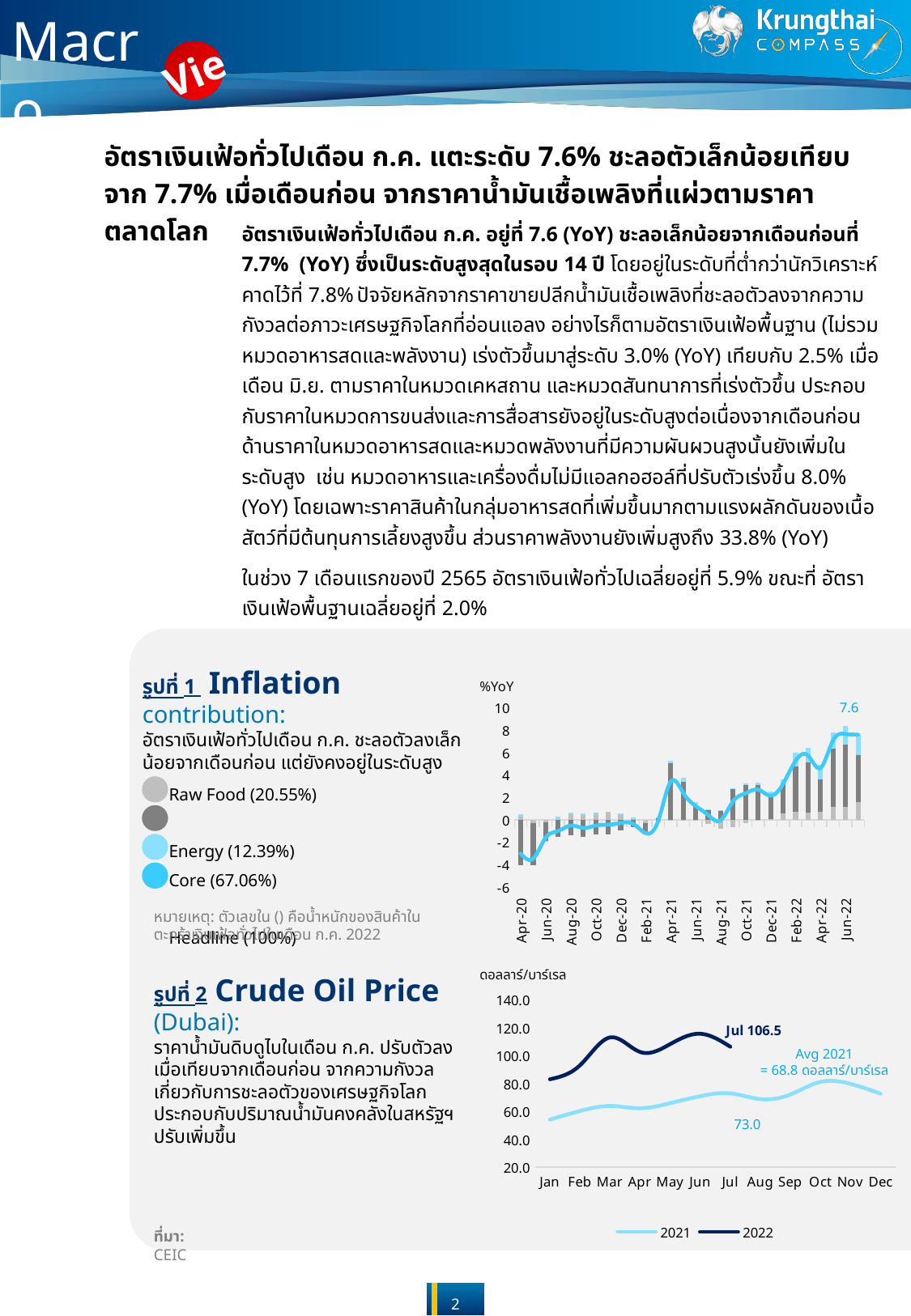
In the Inflation contribution chart, does the Headline line rise or fall from Feb-22 to Jun-22? rise In the Inflation contribution chart, is the Headline value in Apr-20 greater or less than 0? less In the Crude Oil Price (Dubai) chart, which series is higher in Jul, 2021 or 2022? 2022 In the Crude Oil Price (Dubai) chart, what is the difference between the Jul 2022 value and the stated 2021 average? 37.7 How many series does the legend of the Crude Oil Price (Dubai) chart list? 2 In the Crude Oil Price (Dubai) chart, what is the average 2021 price stated on the chart? 68.8 ดอลลาร์/บาร์เรล In the Inflation contribution chart, what weight is shown in the legend for Core? 67.06% In the Inflation contribution chart, what is the labelled value of the Headline line at the end of the series? 7.6 How many months are shown on the x axis of the Crude Oil Price (Dubai) chart? 12 In the Crude Oil Price (Dubai) chart, is the 2022 value in Jan greater or less than 100.0? less What kind of chart is the Crude Oil Price (Dubai) chart? line chart In the Crude Oil Price (Dubai) chart, what is the labelled value of the 2022 series in Jul? 106.5